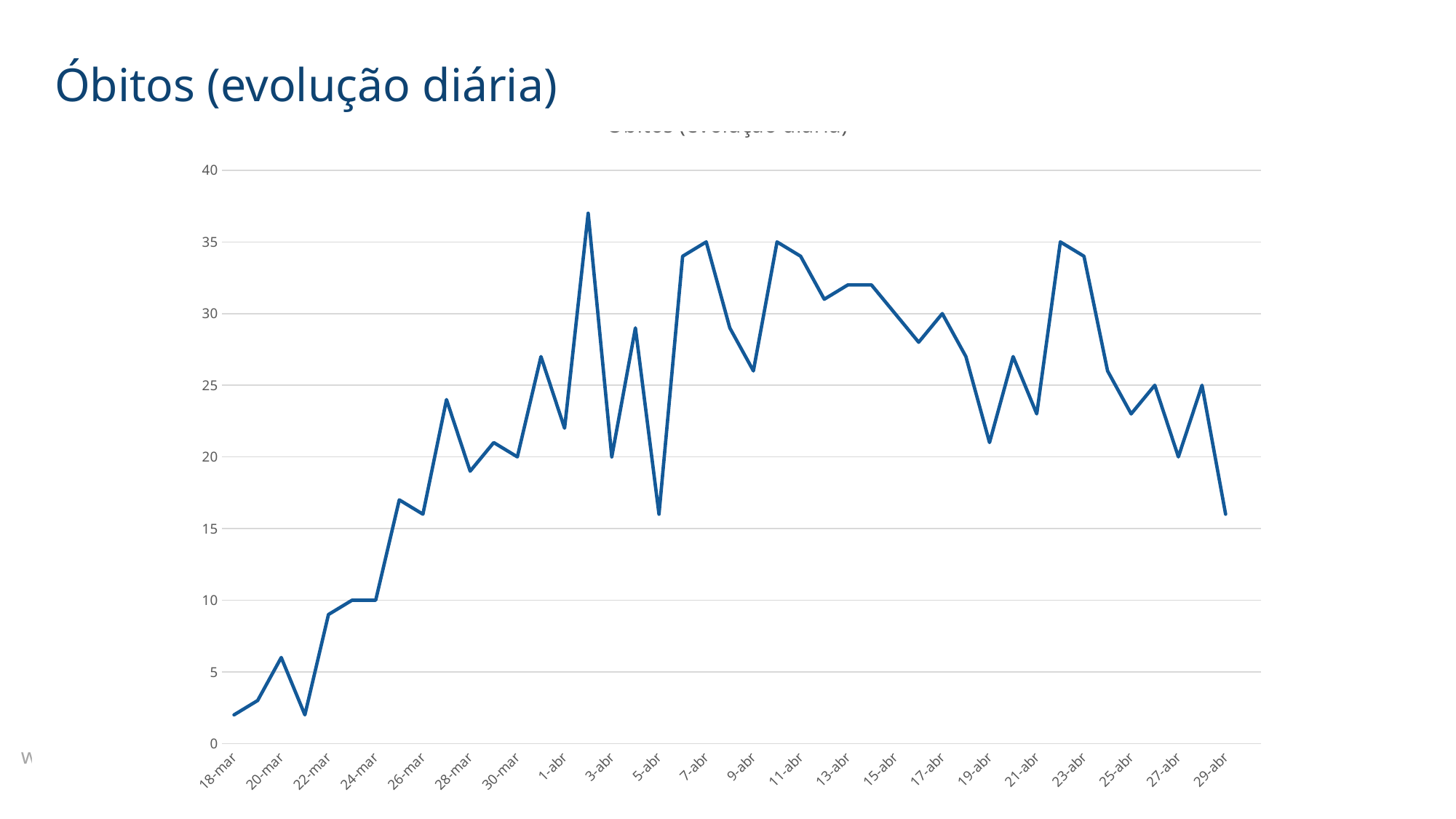
What is the title of the slide? Óbitos (evolução diária) What is the value for 7-abr? 35 What is the value for 24-mar? 10 What kind of chart is shown on the slide? line chart Is the value for 5-abr greater or less than 20? less Between 18-mar and 26-mar, do the values generally rise or fall? rise Is the value for 13-abr greater or less than 30? greater Is the value for 2-abr greater or less than 35? greater Which is larger, the value for 7-abr or the value for 29-abr? 7-abr On which date does the line reach its highest value? 2-abr What is the value for 3-abr? 20